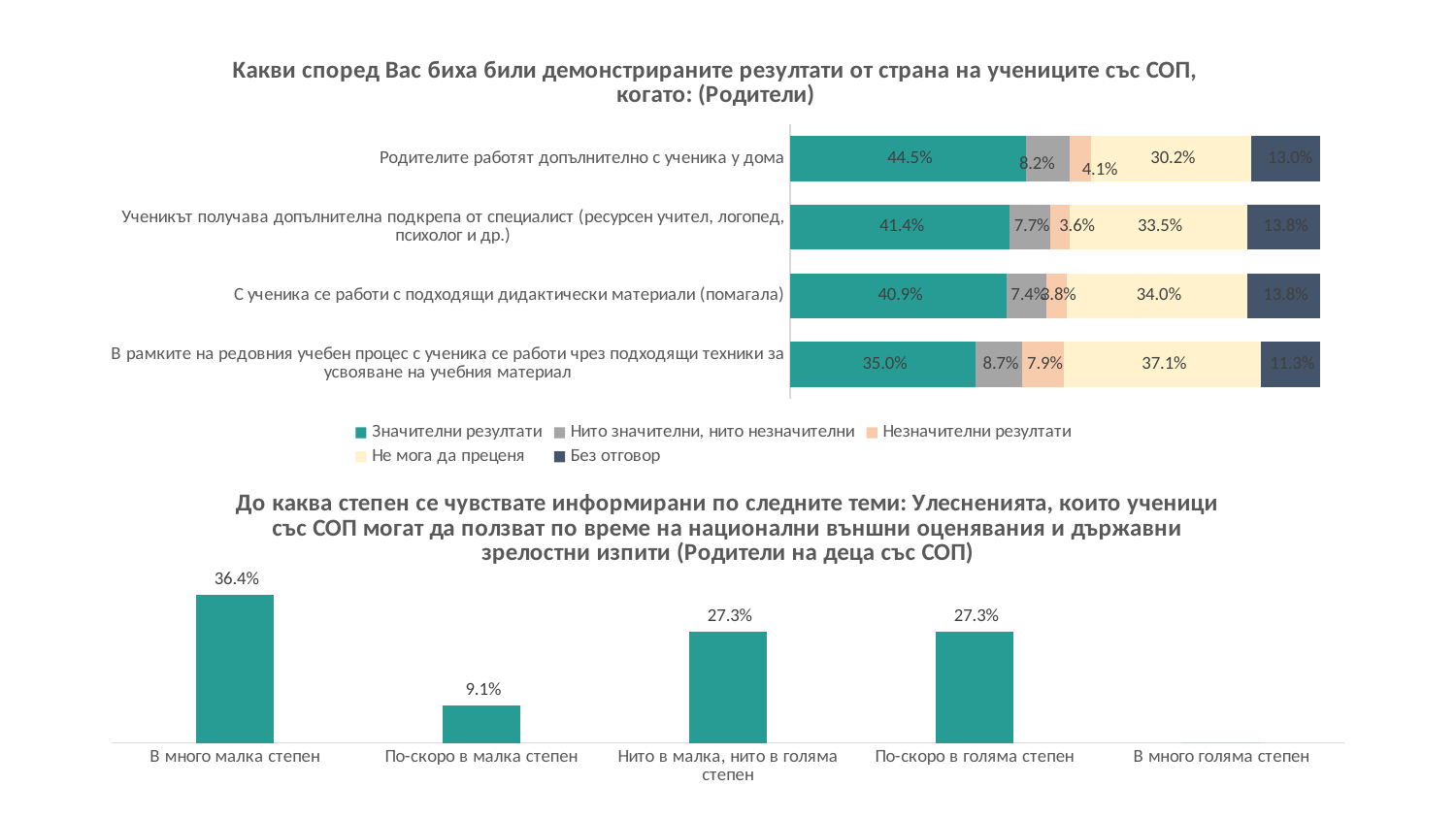
In the bottom chart, which is larger: 'В много малка степен' or 'По-скоро в голяма степен'? В много малка степен In the bottom chart, what is the value for 'По-скоро в малка степен'? 9.1% In the top chart, what percentage of parents expect 'Значителни резултати' when 'Родителите работят допълнително с ученика у дома'? 44.5% In the bottom chart, which category has the highest value? В много малка степен In the bottom chart, what is the difference between 'В много малка степен' and 'Нито в малка, нито в голяма степен'? 9.1 percentage points In the top chart, what is the 'Не мога да преценя' share for 'В рамките на редовния учебен процес с ученика се работи чрез подходящи техники за усвояване на учебния материал'? 37.1% In the top chart, which category has the highest 'Значителни резултати' share? Родителите работят допълнително с ученика у дома How many categories are shown in the top chart? 4 How many series does the legend of the top chart list? 5 What kind of chart is the bottom chart? Bar chart What kind of chart is the top chart? Stacked bar chart In the top chart, what is the difference in 'Значителни резултати' between 'Родителите работят допълнително с ученика у дома' and 'В рамките на редовния учебен процес...'? 9.5 percentage points